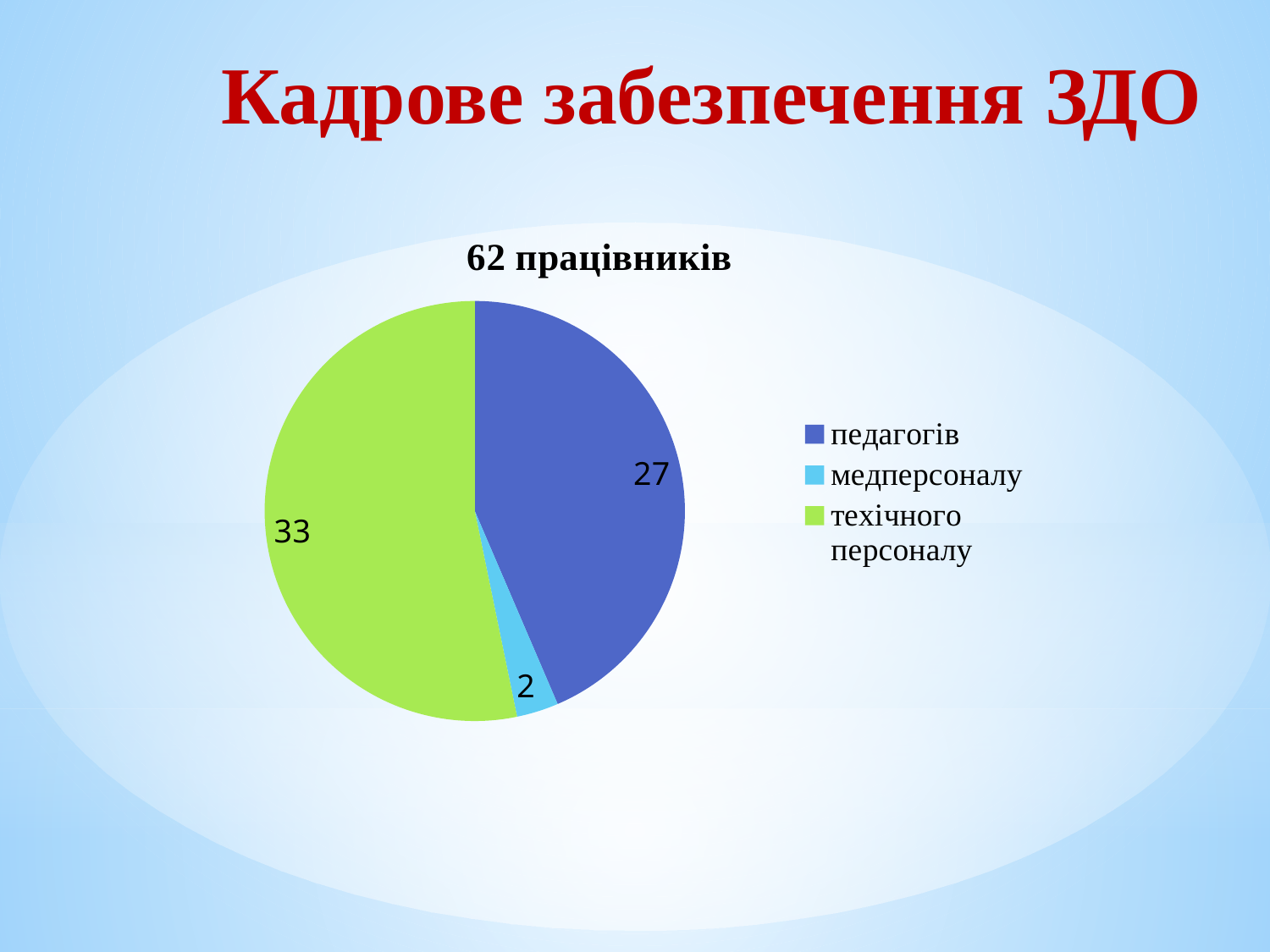
What is the value for педагогів? 27 What is the chart's title? 62 працівників What colour is the slice for медперсоналу? light blue How many categories does the pie chart have? 3 Which category has the smallest slice? медперсоналу How many entries does the legend list? 3 What is the value for медперсоналу? 2 What is the value for техічного персоналу? 33 What is the difference between the values for техічного персоналу and педагогів? 6 Which is larger, the value for педагогів or the value for медперсоналу? педагогів What type of chart is shown on the slide? pie chart Which category has the largest slice? техічного персоналу